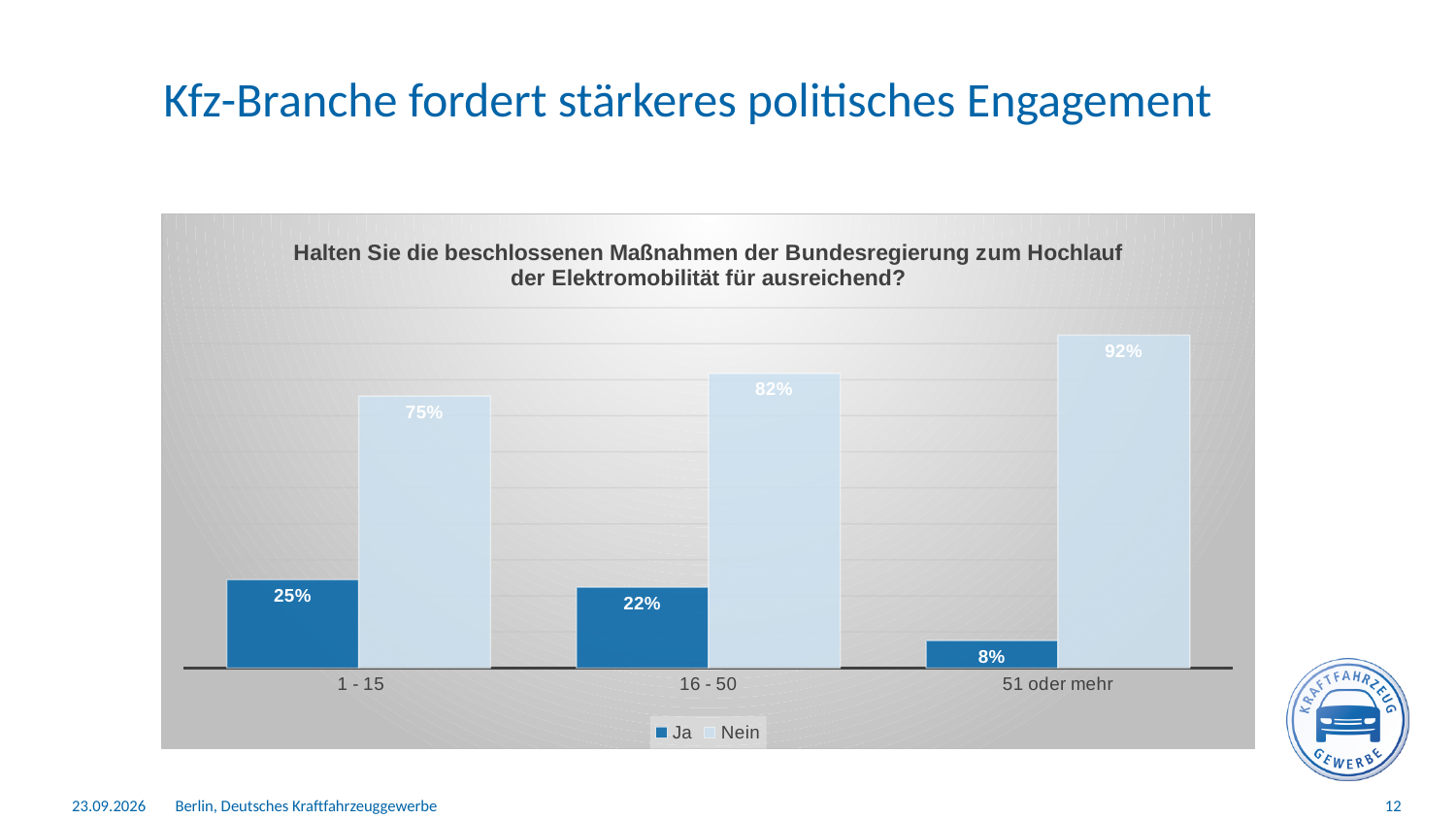
What is the difference between the "Nein" and "Ja" values in the "16 - 50" category? 60% What is the value for "Nein" in the "16 - 50" category? 82% What is the value for "Nein" in the "1 - 15" category? 75% Which category has the highest "Nein" value? 51 oder mehr Do the "Nein" values rise or fall from left to right along the x axis? Rise What is the value for "Ja" in the "51 oder mehr" category? 8% Which category has the lowest "Ja" value? 51 oder mehr What is the value for "Ja" in the "1 - 15" category? 25% How many series does the legend list? 2 What kind of chart is shown on the slide? Bar chart How many categories are shown on the x axis? 3 Which is larger: the "Ja" value for "1 - 15" or the "Ja" value for "16 - 50"? 1 - 15